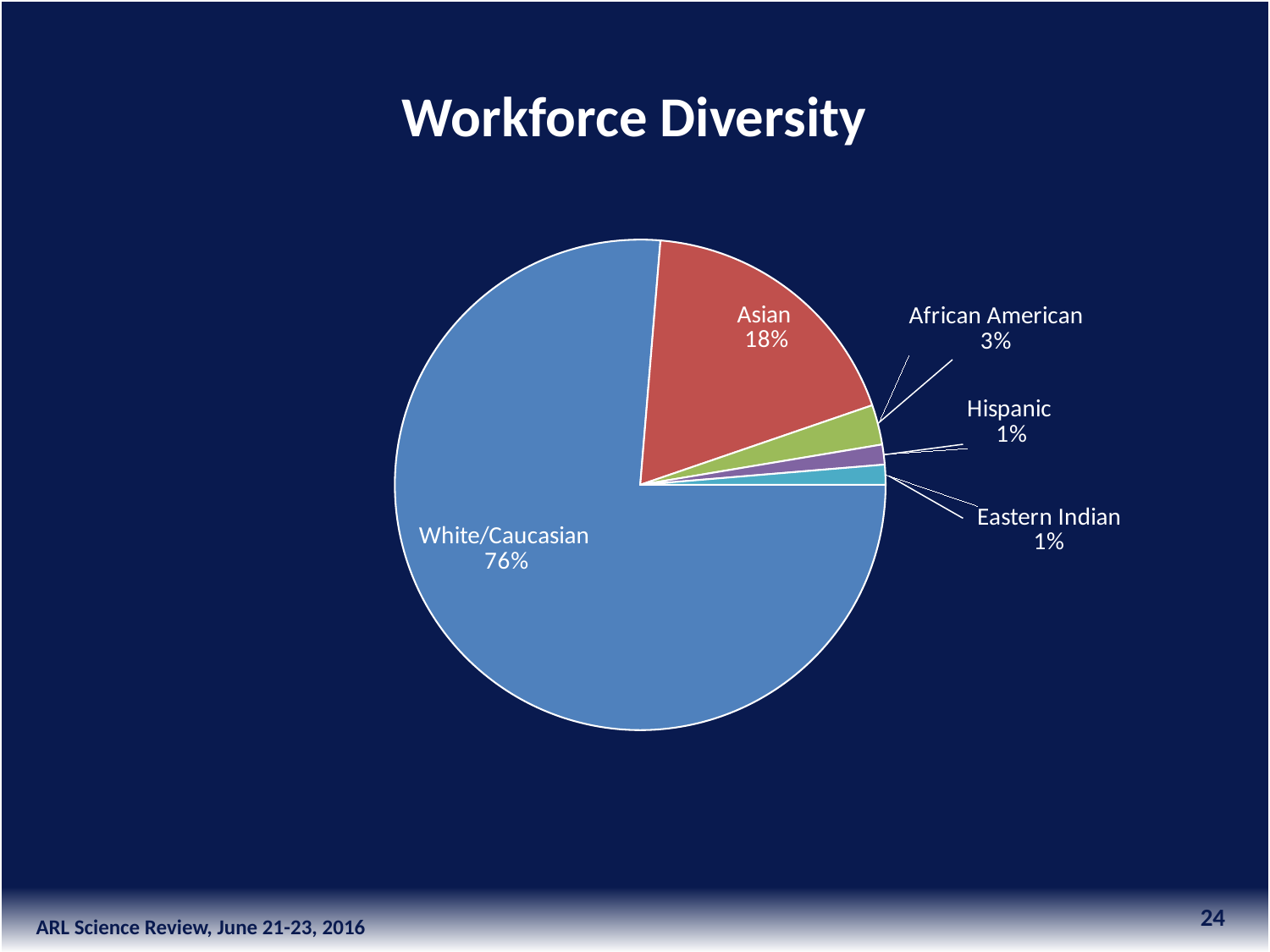
What kind of chart is shown on the slide? pie chart What is the difference in percentage points between the White/Caucasian and Asian slices? 58 What is the title of the chart? Workforce Diversity How many categories are shown in the pie chart? 5 Which is larger, the Asian slice or the African American slice? Asian What share of the workforce is Hispanic? 1% Which category has the largest slice of the pie? White/Caucasian What share of the workforce is Asian? 18% What is the difference in percentage points between the Asian and African American slices? 15 What share of the workforce is White/Caucasian? 76% What share of the workforce is African American? 3% What colour is the Asian slice? red